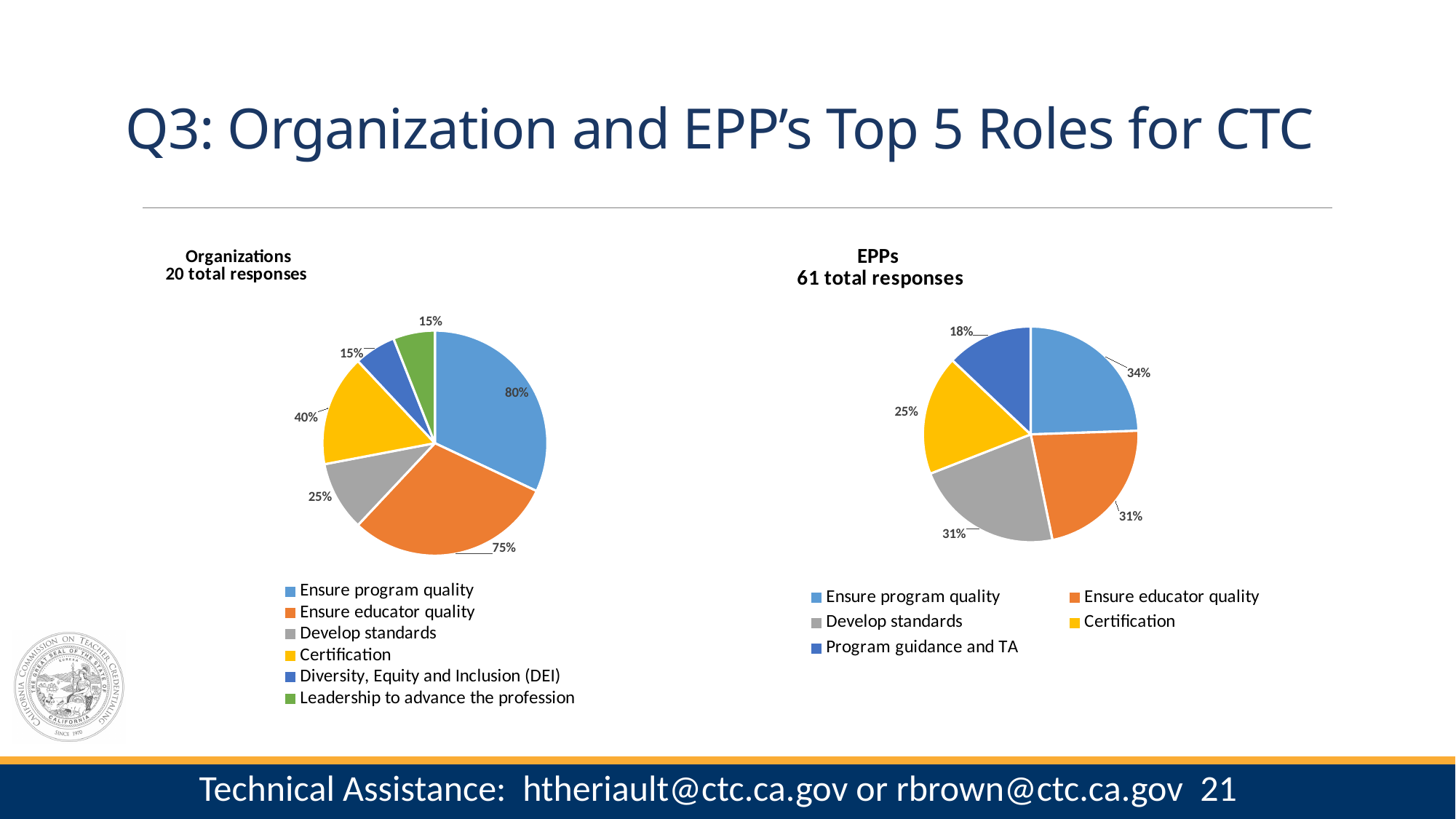
How many categories does the legend of the Organizations chart list? 6 How many categories does the legend of the EPPs chart list? 5 In the Organizations chart, which is larger: Certification or Develop standards? Certification In the Organizations chart, what percentage is shown for Ensure program quality? 80% In the EPPs chart, what percentage is shown for Program guidance and TA? 18% In the Organizations chart, what is the difference between the percentages for Ensure educator quality and Develop standards? 50% In the EPPs chart, what percentage is shown for Certification? 25% In the Organizations chart, what percentage is shown for Certification? 40% In the Organizations chart, which category has the highest percentage? Ensure program quality In the EPPs chart, what is the difference between the percentages for Ensure program quality and Certification? 9% In the EPPs chart, which category has the lowest percentage? Program guidance and TA What type of chart is the EPPs chart? Pie chart